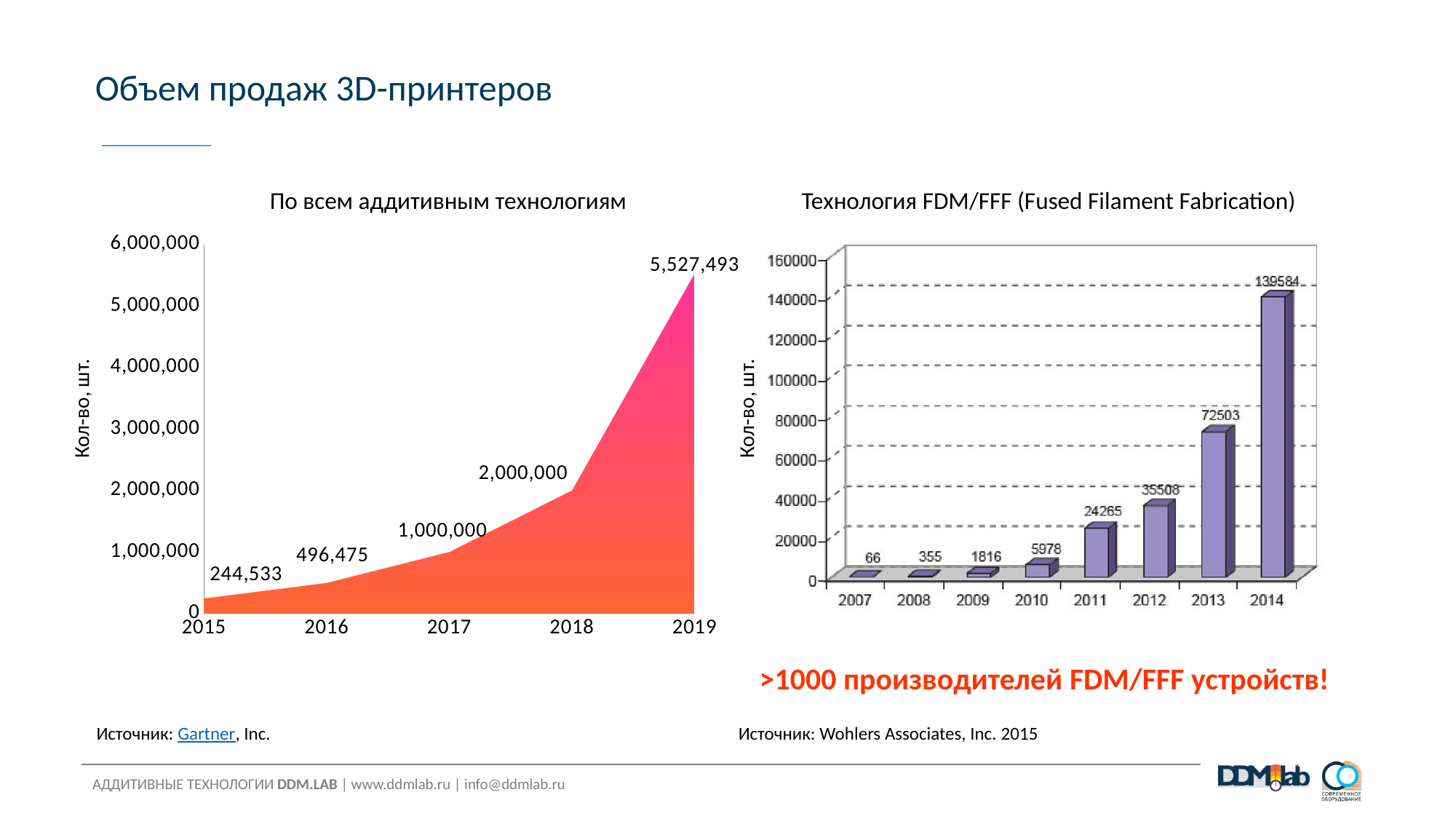
In the chart 'По всем аддитивным технологиям', what is the difference between the values for 2018 and 2017? 1,000,000 In the chart 'По всем аддитивным технологиям', what is the value for 2016? 496,475 In the chart 'Технология FDM/FFF (Fused Filament Fabrication)', what is the value for 2011? 24265 In the chart 'Технология FDM/FFF (Fused Filament Fabrication)', how many years are plotted? 8 What kind of chart is 'Технология FDM/FFF (Fused Filament Fabrication)'? bar chart In the chart 'По всем аддитивным технологиям', do the values rise or fall from 2015 to 2019? rise In the chart 'Технология FDM/FFF (Fused Filament Fabrication)', what is the difference between the values for 2013 and 2012? 36995 In the chart 'По всем аддитивным технологиям', what is the value for 2019? 5,527,493 In the chart 'По всем аддитивным технологиям', how many years are plotted? 5 In the chart 'Технология FDM/FFF (Fused Filament Fabrication)', which year has the highest value? 2014 In the chart 'Технология FDM/FFF (Fused Filament Fabrication)', what is the value for 2014? 139584 In the chart 'По всем аддитивным технологиям', which year has the lowest value? 2015